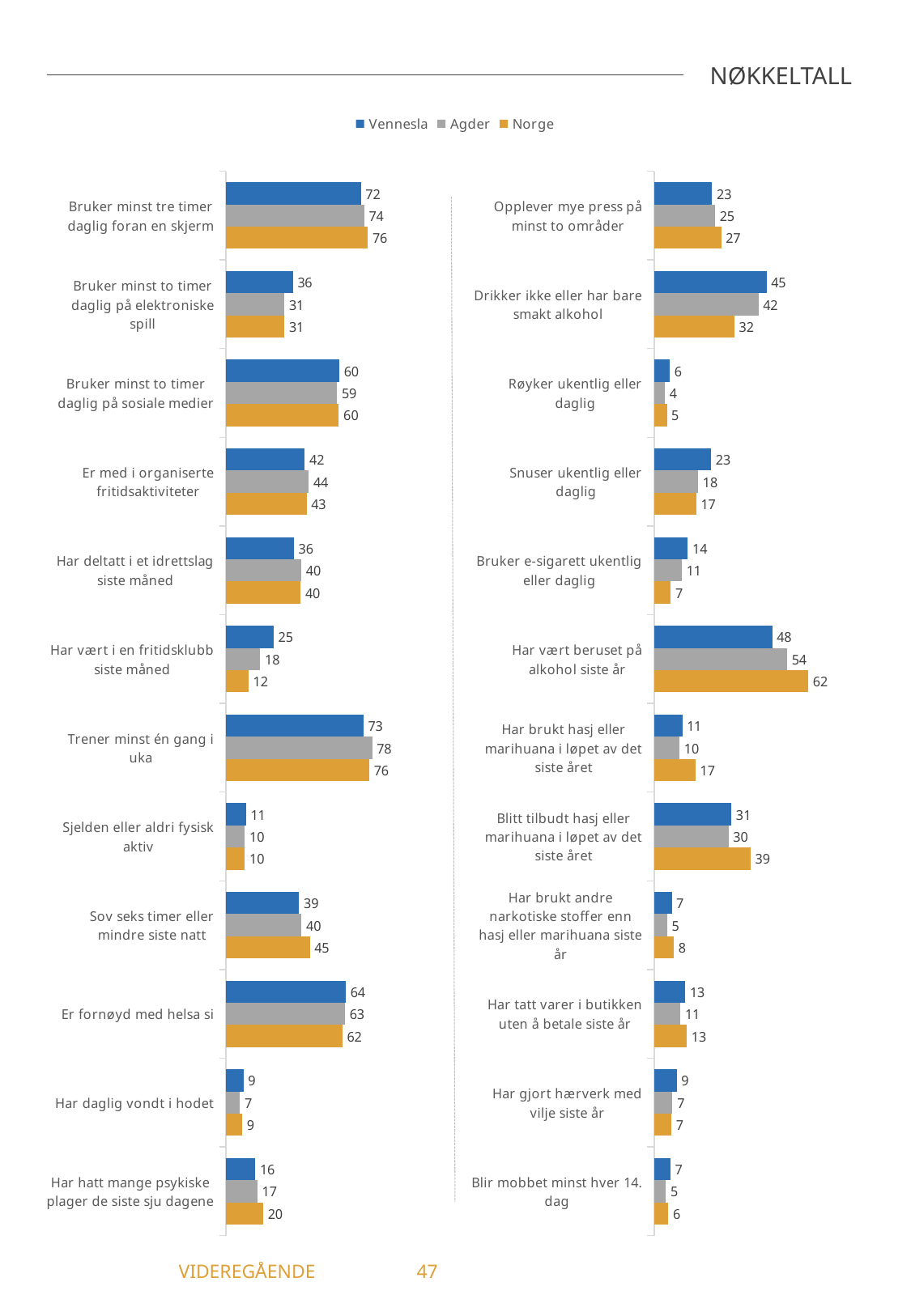
On the right chart, what is the total of the three values for "Røyker ukentlig eller daglig"? 15 Which colour represents Agder in the legend? grey On the right chart, which category has the highest Vennesla value? Har vært beruset på alkohol siste år On the left chart, what is the Agder value for "Har vært i en fritidsklubb siste måned"? 18 On the right chart, what is the difference between the Norge and Vennesla values for "Har brukt hasj eller marihuana i løpet av det siste året"? 6 On the left chart, which is larger for "Sov seks timer eller mindre siste natt": the Vennesla value or the Norge value? Norge How many categories are shown on the right chart? 12 How many series does the legend list? 3 On the left chart, which category has the lowest Norge value? Har daglig vondt i hodet On the left chart, what is the Vennesla value for "Bruker minst tre timer daglig foran en skjerm"? 72 What kind of chart is the left chart? bar chart On the right chart, what is the Norge value for "Har vært beruset på alkohol siste år"? 62